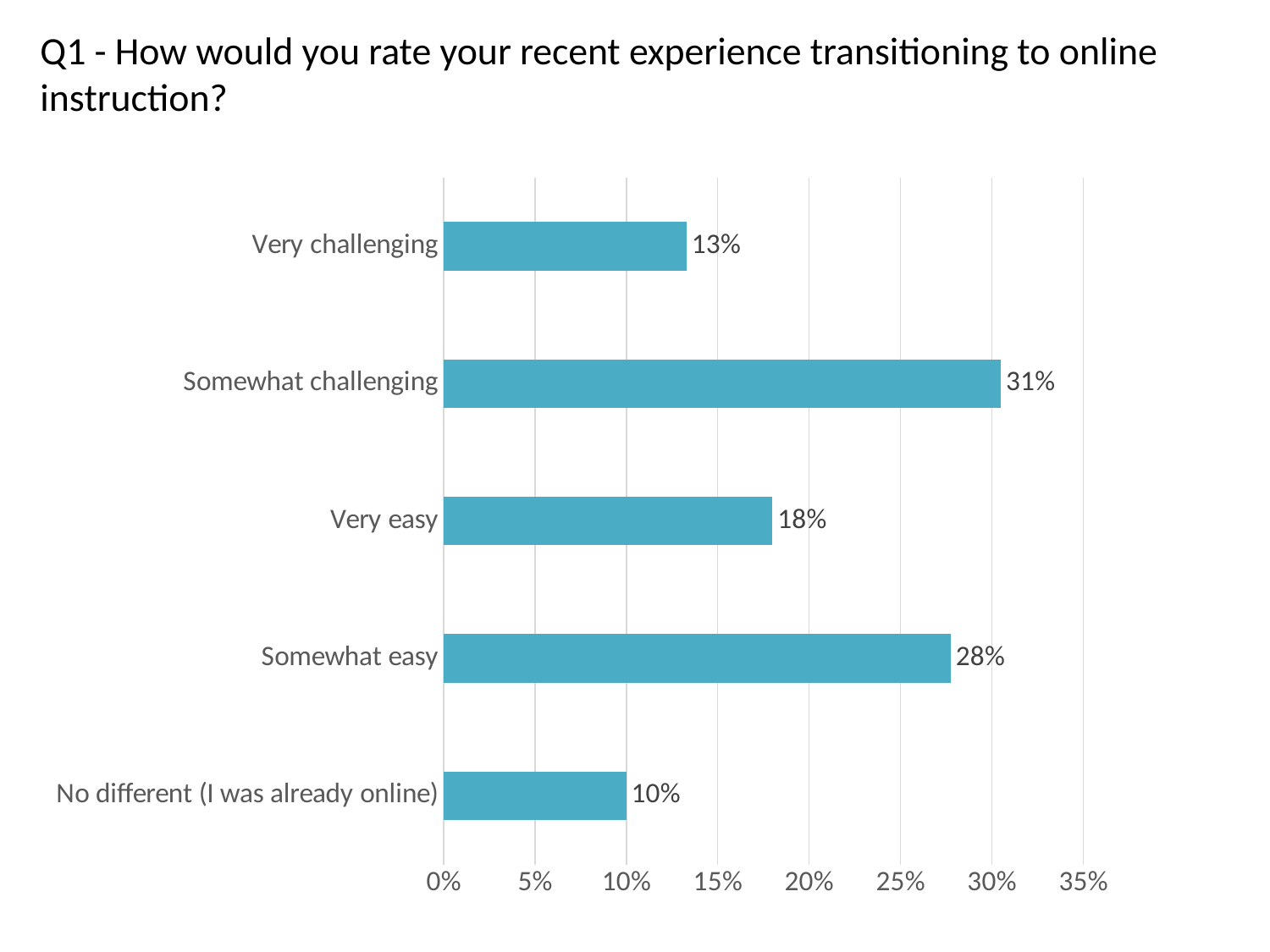
What kind of chart is shown on the slide? Bar chart What is the value for Somewhat challenging? 31% Which category has the lowest value? No different (I was already online) Which category has the highest value? Somewhat challenging What is the difference between the Somewhat challenging and Somewhat easy values? 3% What is the value for No different (I was already online)? 10% What is the difference between the Very easy and Very challenging values? 5% What percentage of respondents rated their transition as Very challenging? 13% How many categories are shown in the chart? 5 What percentage of respondents said the transition was Very easy? 18% Which is larger, the value for Very easy or the value for Very challenging? Very easy What is the highest value shown on the x axis? 35%